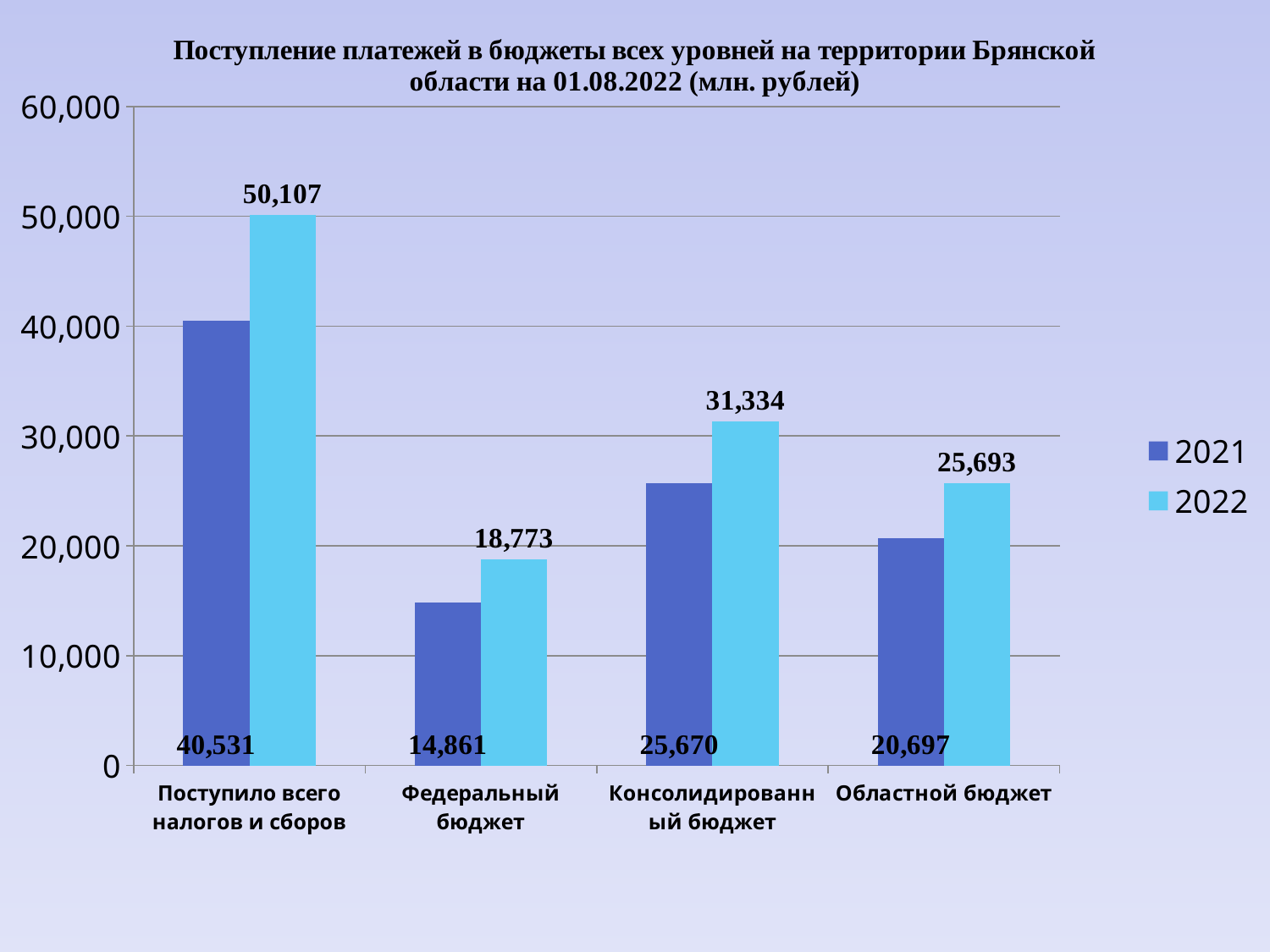
How many categories are shown on the x axis? 4 What is the difference between the 2022 and 2021 values for Областной бюджет? 4,996 What is the difference between the 2022 and 2021 values for Поступило всего налогов и сборов? 9,576 Which category has the highest 2021 value? Поступило всего налогов и сборов Which is larger: the 2021 value for Консолидированный бюджет or the 2022 value for Областной бюджет? 2022 value for Областной бюджет Which category has the lowest 2022 value? Федеральный бюджет What is the 2022 value for Поступило всего налогов и сборов? 50,107 What is the 2021 value for Федеральный бюджет? 14,861 How many series does the legend list? 2 What kind of chart is shown on the slide? Bar chart What is the 2021 value for Областной бюджет? 20,697 What is the 2022 value for Консолидированный бюджет? 31,334